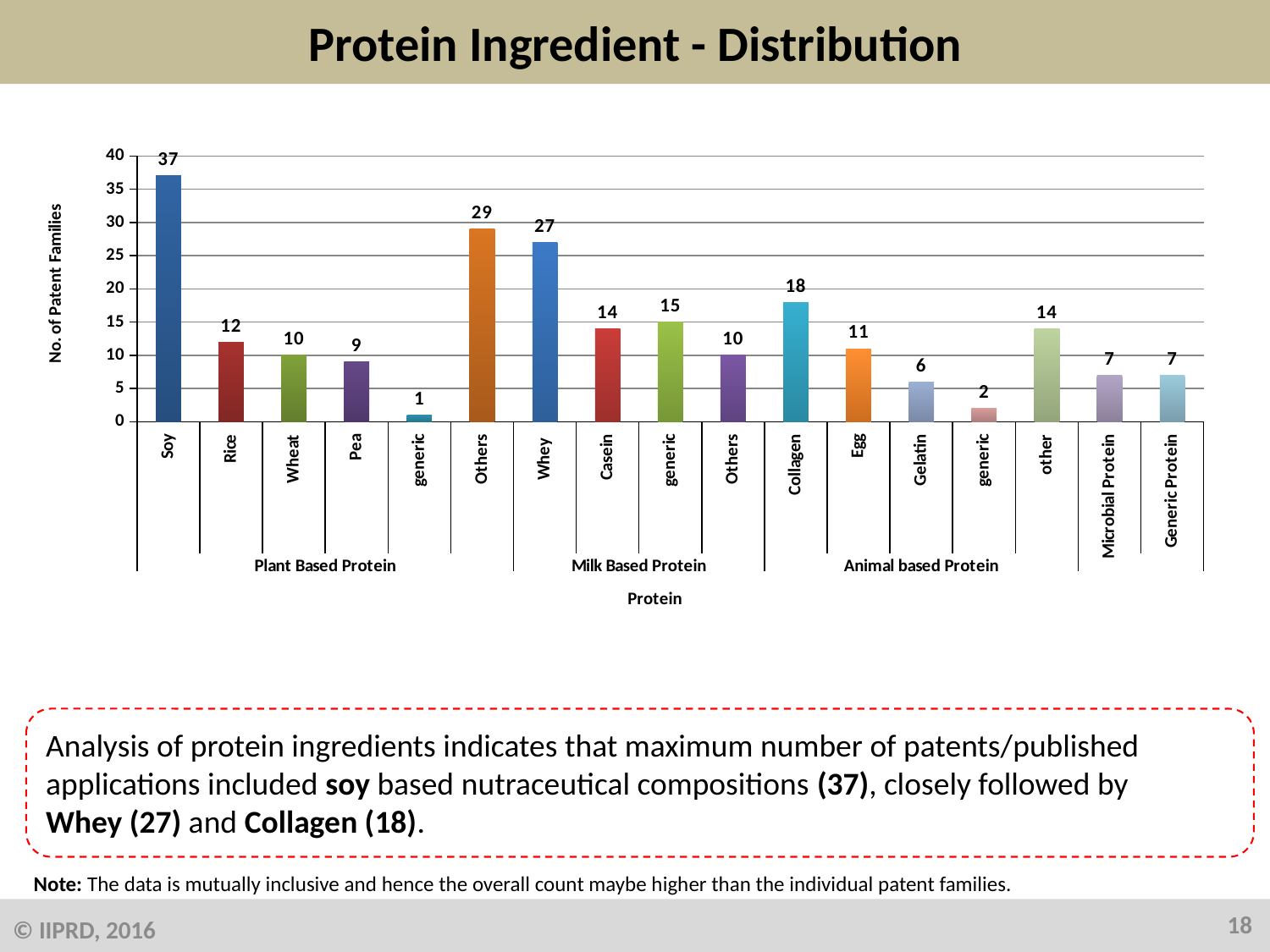
What is the difference in patent families between Soy and Whey? 10 What is the number of patent families for Soy? 37 What is the difference in patent families between Others in Plant Based Protein and Others in Milk Based Protein? 19 Which protein ingredient has the highest number of patent families? Soy How many bars are plotted in the chart? 17 Which protein ingredient has the lowest number of patent families? generic (Plant Based Protein) What is the label of the vertical axis of the chart? No. of Patent Families What is the number of patent families for Gelatin? 6 What is the number of patent families for Whey? 27 What type of chart is shown on the slide? Bar chart What is the number of patent families for Collagen? 18 Which has more patent families, Casein or Egg? Casein